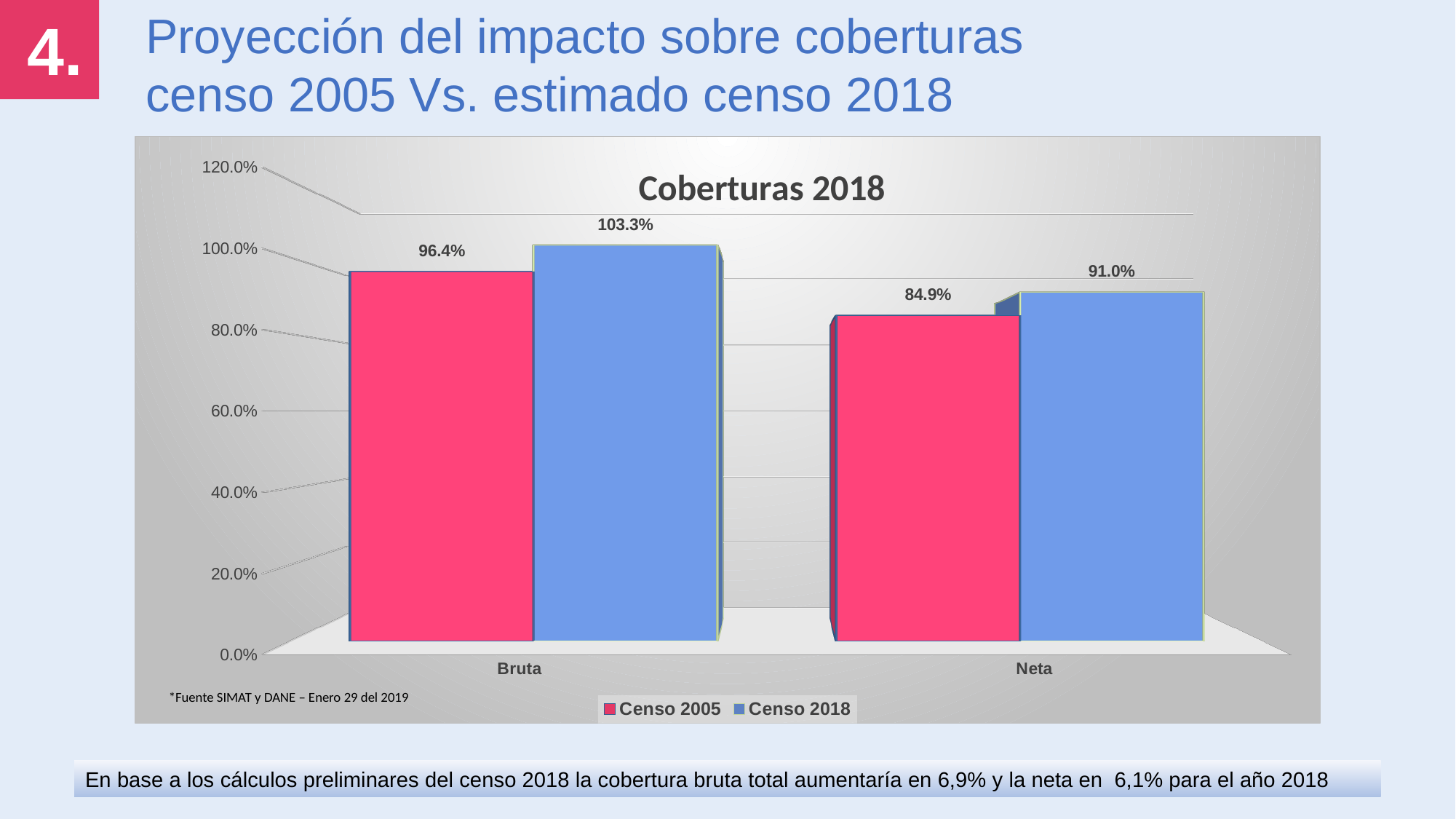
What is the difference between the Censo 2018 and Censo 2005 values for Neta? 6.1% What is the Censo 2018 value for Bruta? 103.3% Which is larger for Neta: Censo 2005 or Censo 2018? Censo 2018 Which bar has the highest value in the chart? Censo 2018, Bruta What is the difference between the Censo 2018 and Censo 2005 values for Bruta? 6.9% What is the Censo 2018 value for Neta? 91.0% Which bar has the lowest value in the chart? Censo 2005, Neta What is the title of the chart? Coberturas 2018 What is the Censo 2005 value for Bruta? 96.4% How many series does the legend list? 2 What is the Censo 2005 value for Neta? 84.9% How many categories are shown on the x axis? 2